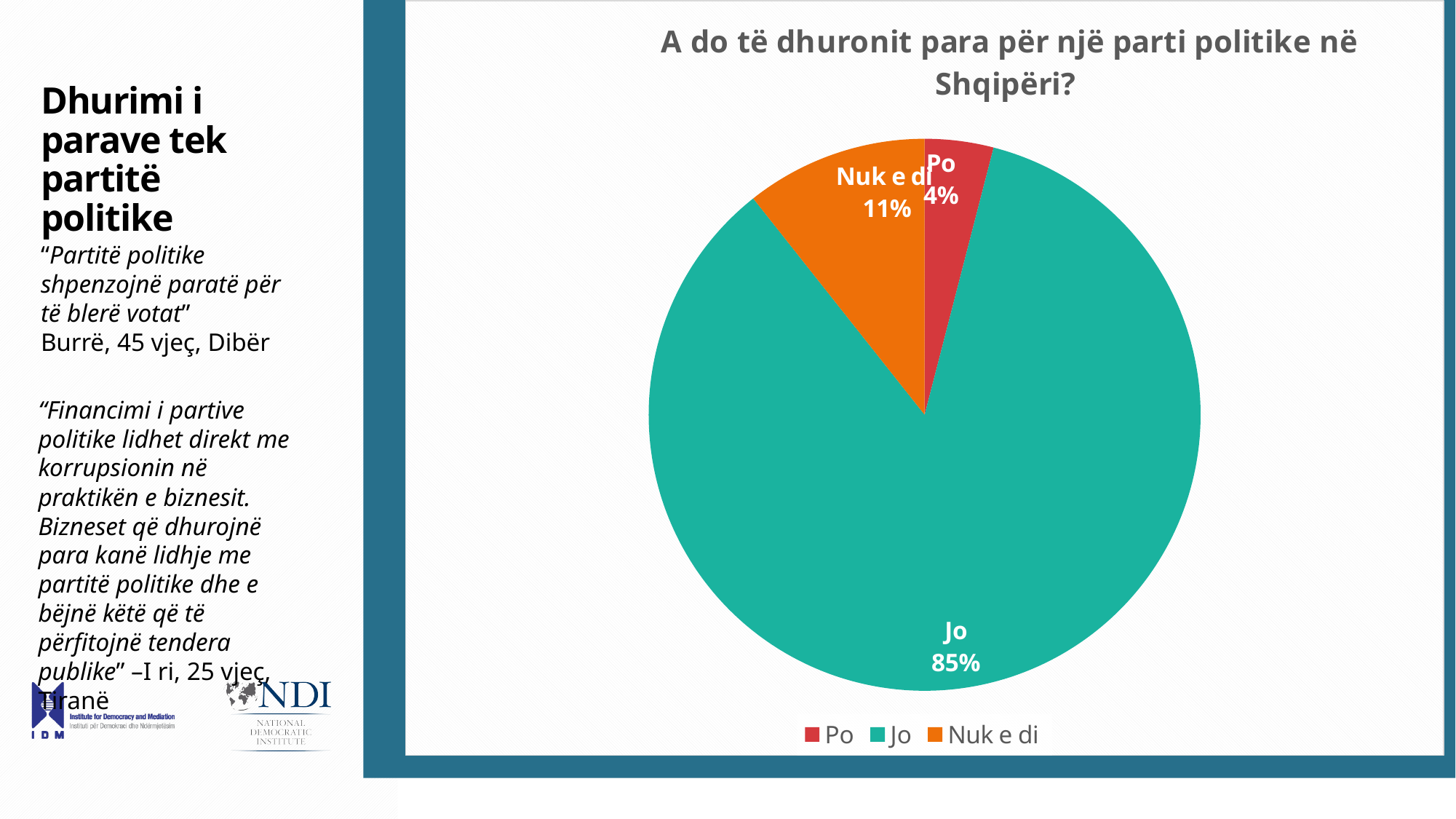
Which category has the largest share of the pie? Jo What percentage of respondents answered "Nuk e di"? 11% What is the title of the chart? A do të dhuronit para për një parti politike në Shqipëri? What colour is the "Nuk e di" slice? orange Which is larger, the share for "Nuk e di" or the share for "Po"? Nuk e di What kind of chart is shown on the slide? pie chart What is the difference in percentage points between "Nuk e di" and "Po"? 7 How many categories does the pie chart show? 3 What percentage of respondents answered "Po"? 4% What percentage of respondents answered "Jo"? 85% What is the difference in percentage points between "Jo" and "Nuk e di"? 74 Which category has the smallest share of the pie? Po